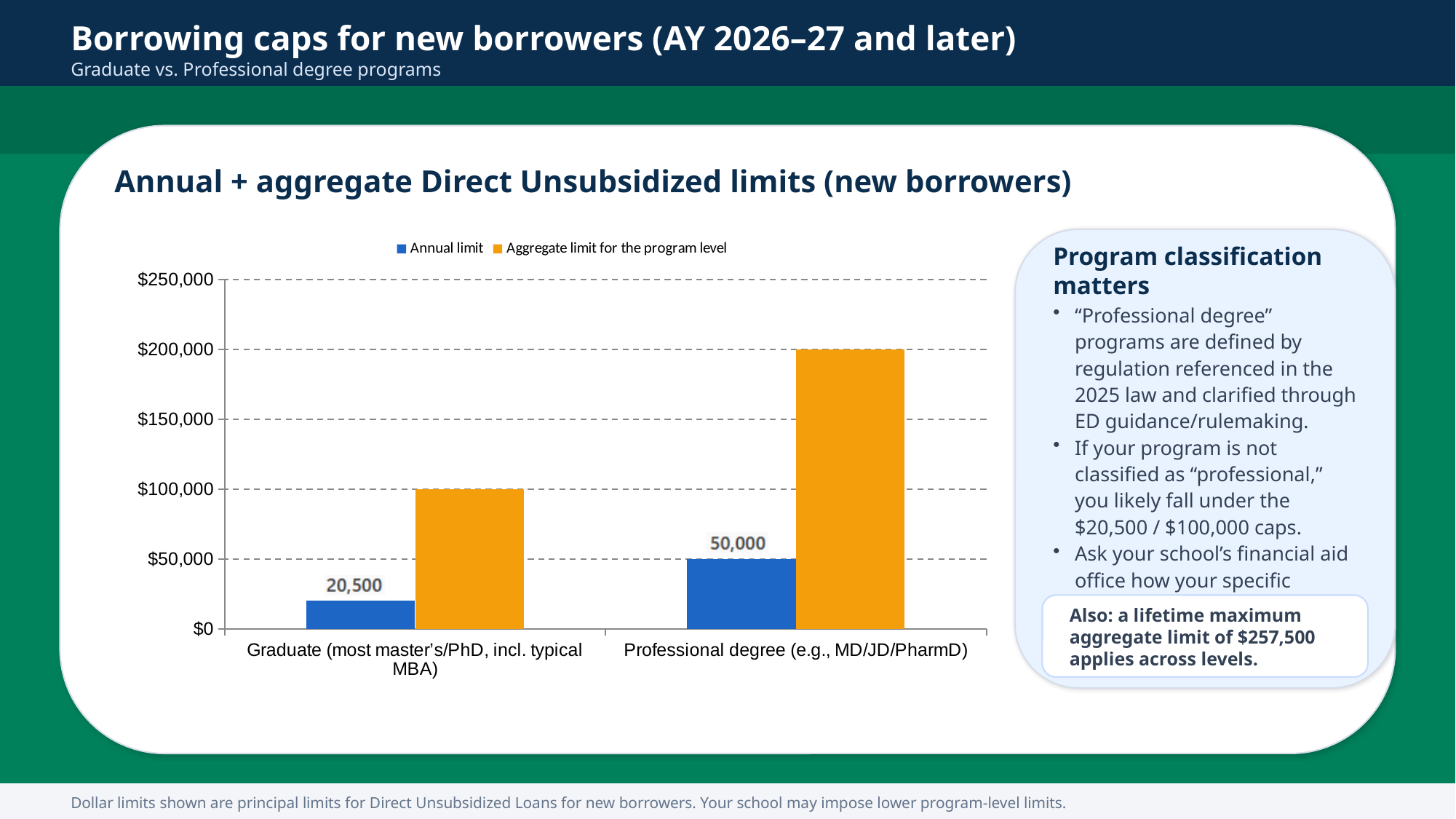
What is the annual limit for the Graduate (most master's/PhD, incl. typical MBA) category? 20,500 What type of chart is shown on the slide? Bar chart Is the annual limit for the Graduate category greater or less than $50,000? less How many series does the chart legend list? 2 What is the difference between the annual limit for Professional degree and the annual limit for Graduate? 29,500 Which category has the lower aggregate limit for the program level? Graduate (most master's/PhD, incl. typical MBA) Which category has the higher annual limit? Professional degree (e.g., MD/JD/PharmD) Is the aggregate limit for the Professional degree category greater or less than $150,000? greater What is the aggregate limit for the program level for the Professional degree category? $200,000 What is the annual limit for the Professional degree (e.g., MD/JD/PharmD) category? 50,000 How many categories are shown on the x axis of the chart? 2 What is the aggregate limit for the program level for the Graduate category? $100,000